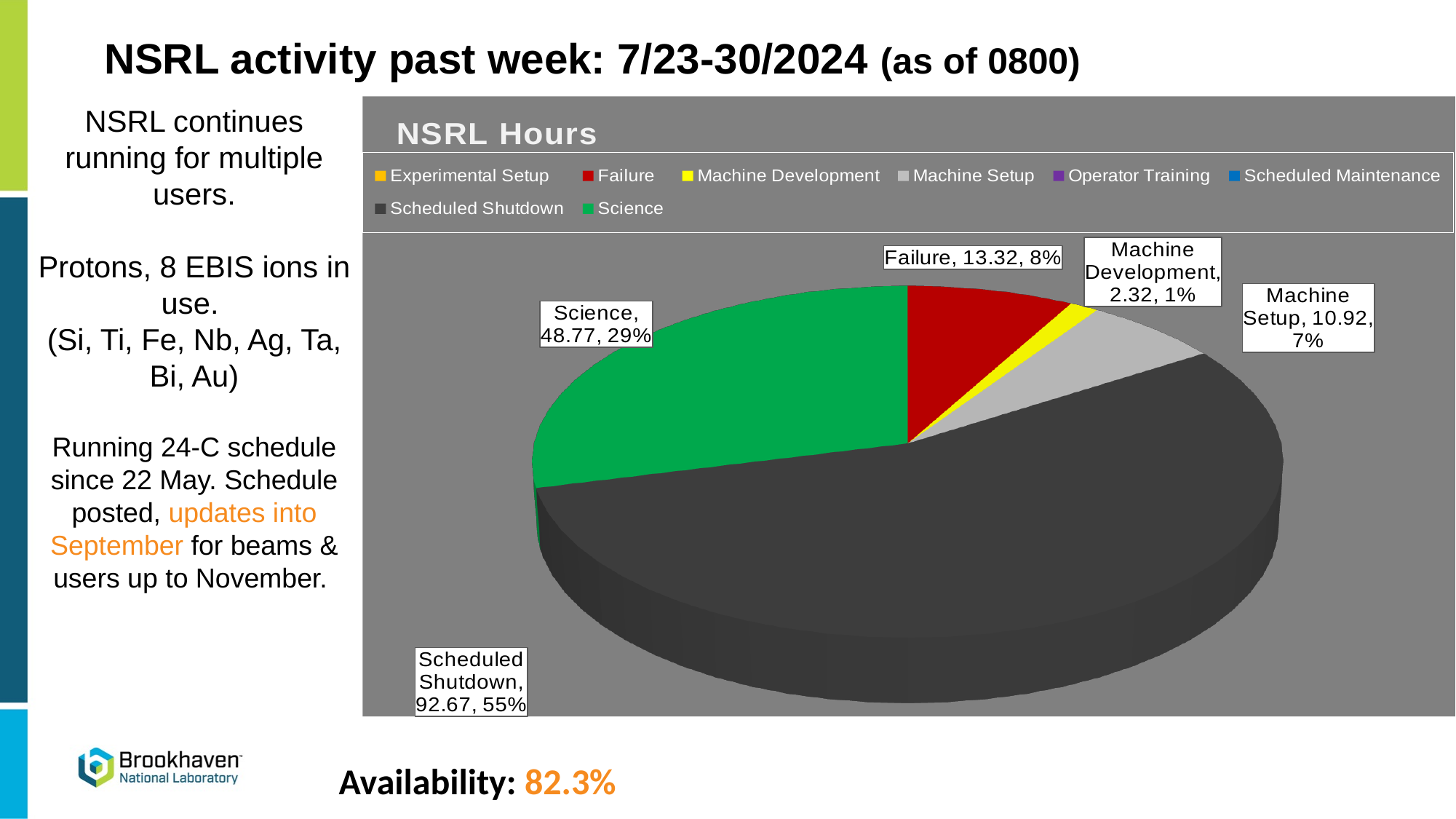
What percentage share of the pie does Machine Development have? 1% How many hours are shown for Scheduled Shutdown? 92.67 What percentage share of the pie does Machine Setup have? 7% How many slices of the pie have data labels? 5 What is the difference in hours between Science and Failure? 35.45 What is the title of the chart? NSRL Hours How many hours are shown for Failure? 13.32 How many hours are shown for Science? 48.77 Which category has the largest slice of the pie? Scheduled Shutdown Which has more hours, Machine Setup or Failure? Failure How many entries does the chart legend list? 8 What type of chart is shown on the slide? pie chart